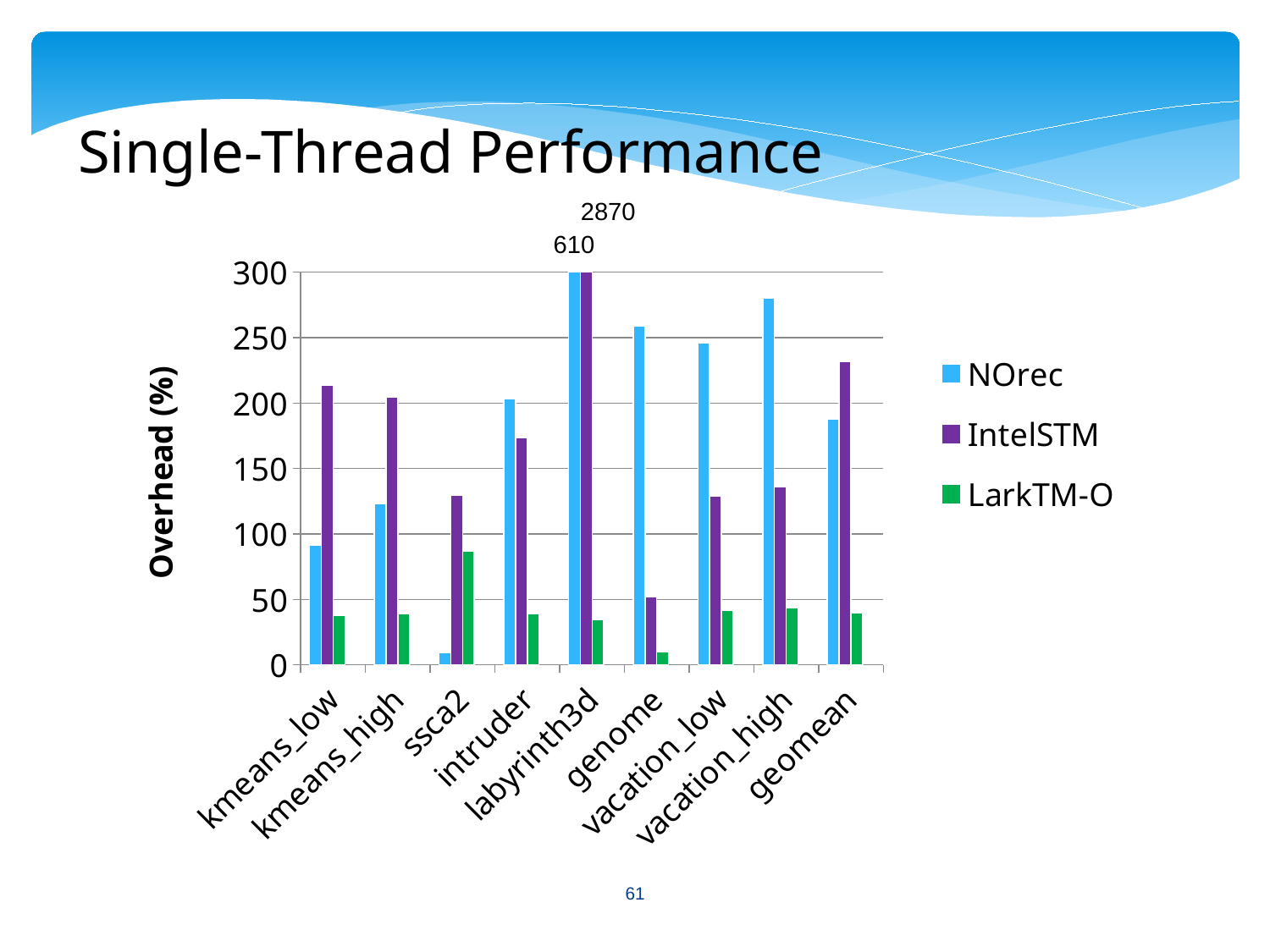
Which series is shown in green? LarkTM-O Is the IntelSTM value for geomean greater or less than 200? greater What kind of chart is shown on the slide? bar chart For genome, which is larger: NOrec or IntelSTM? NOrec For kmeans_low, which is larger: NOrec or IntelSTM? IntelSTM Is the NOrec value for vacation_high greater or less than 250? greater Is the NOrec value for kmeans_low greater or less than 100? less How many categories are shown along the x axis? 9 How many series does the legend list? 3 For which category is the LarkTM-O value lowest? genome What is the label of the y axis? Overhead (%)